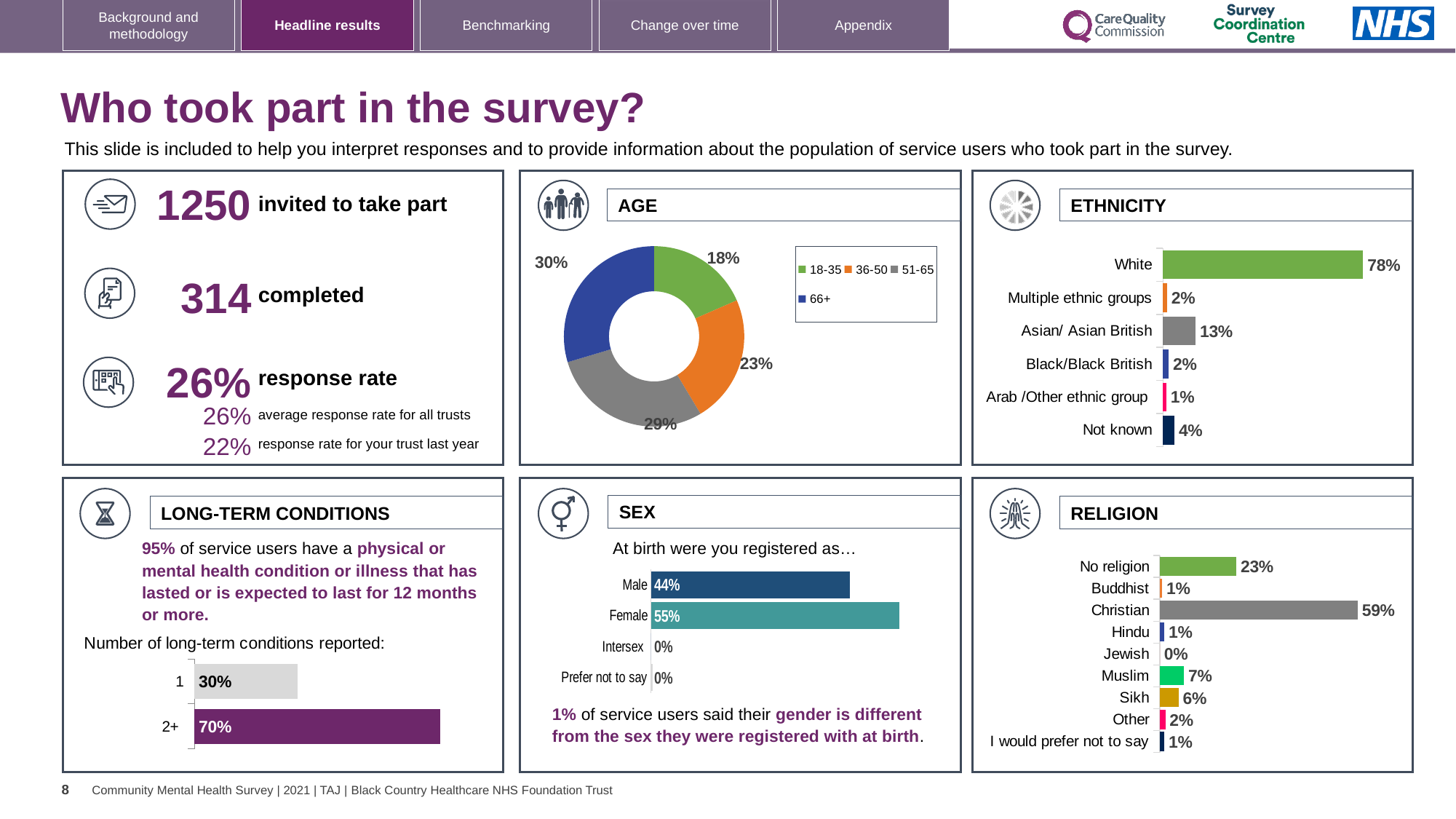
In the ETHNICITY chart, what is the value for Asian/ Asian British? 13% In the AGE chart, which age group has the smallest share? 18-35 How many ethnic categories are shown in the ETHNICITY chart? 6 In the SEX chart, which is larger, Male or Female? Female What kind of chart is the AGE chart? Donut chart In the AGE chart, what percentage of respondents were aged 66+? 30% In the SEX chart, what is the difference between Female and Male? 11% In the ETHNICITY chart, what is the difference between White and Not known? 74% How many categories are shown in the RELIGION chart? 9 In the LONG-TERM CONDITIONS chart, what percentage reported 2+ conditions? 70% How many entries does the legend of the AGE chart list? 4 In the RELIGION chart, which religion category has the highest value? Christian